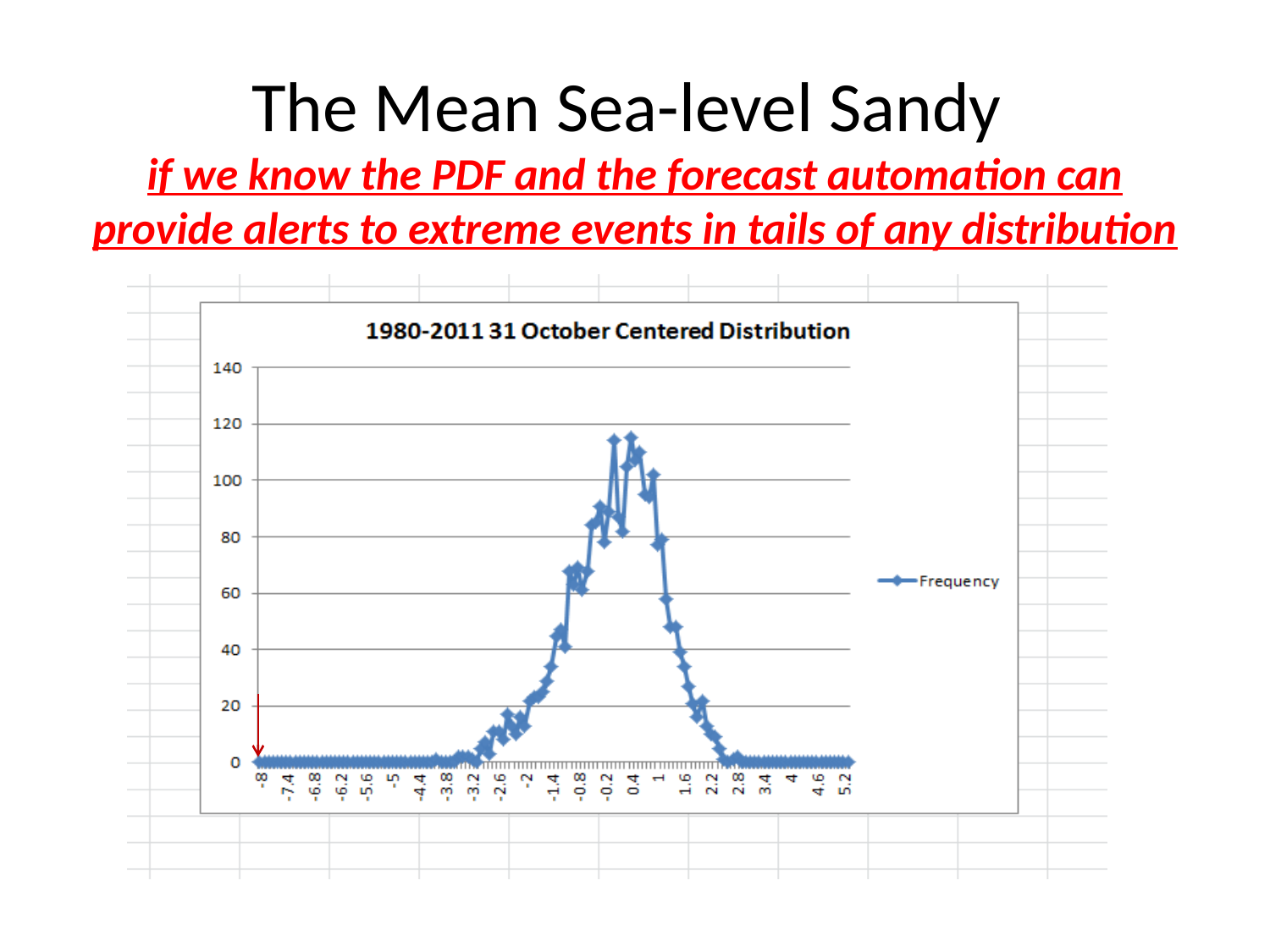
What kind of chart is shown on the slide? line chart What is the Frequency value at x = 5.2? 0 How many series does the chart legend list? 1 Is the Frequency value at x = -2 greater or less than 40? less Do the Frequency values rise or fall along the x axis from 0.4 to 5.2? fall What is the Frequency value at x = -8? 0 Is the Frequency value at x = 0.4 greater or less than 100? greater What is the name of the series shown in the chart legend? Frequency Which has the larger Frequency value, x = -2 or x = -0.8? -0.8 What is the title of the chart? 1980-2011 31 October Centered Distribution Which has the larger Frequency value, x = 0.4 or x = 2.2? 0.4